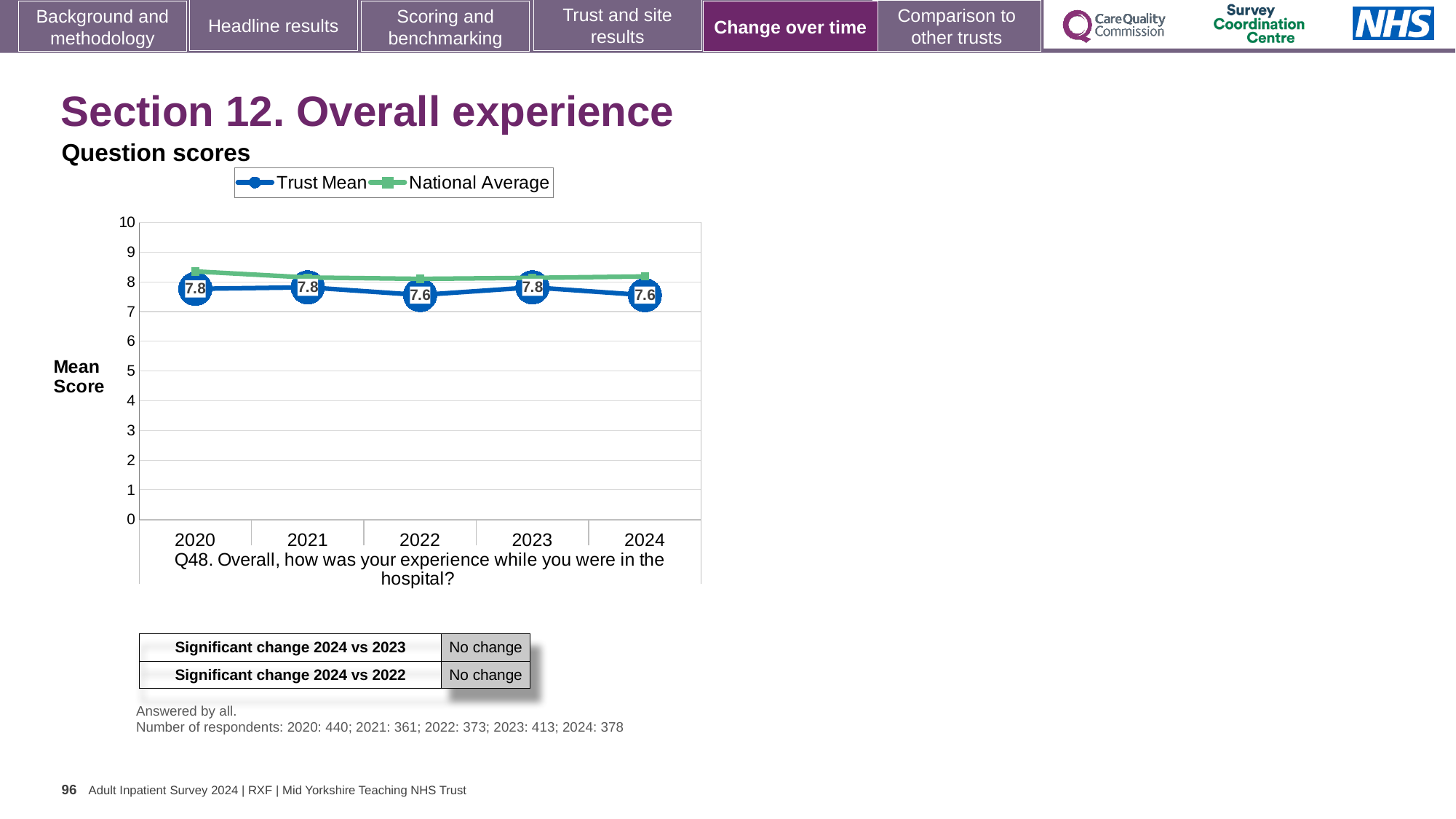
What is the difference between the Trust Mean scores for 2021 and 2022? 0.2 Is the National Average value for 2020 greater or less than 8? greater What is the Trust Mean score for 2020? 7.8 In 2022, which series has the higher value, Trust Mean or National Average? National Average How many years are plotted on the x axis? 5 Which is larger, the Trust Mean score for 2023 or for 2024? 2023 What is the Trust Mean score for 2022? 7.6 How many series does the legend list? 2 What is the Trust Mean score for 2024? 7.6 What is the Trust Mean score for 2023? 7.8 What kind of chart is shown on the slide? Line chart What is the label on the y axis of the chart? Mean Score